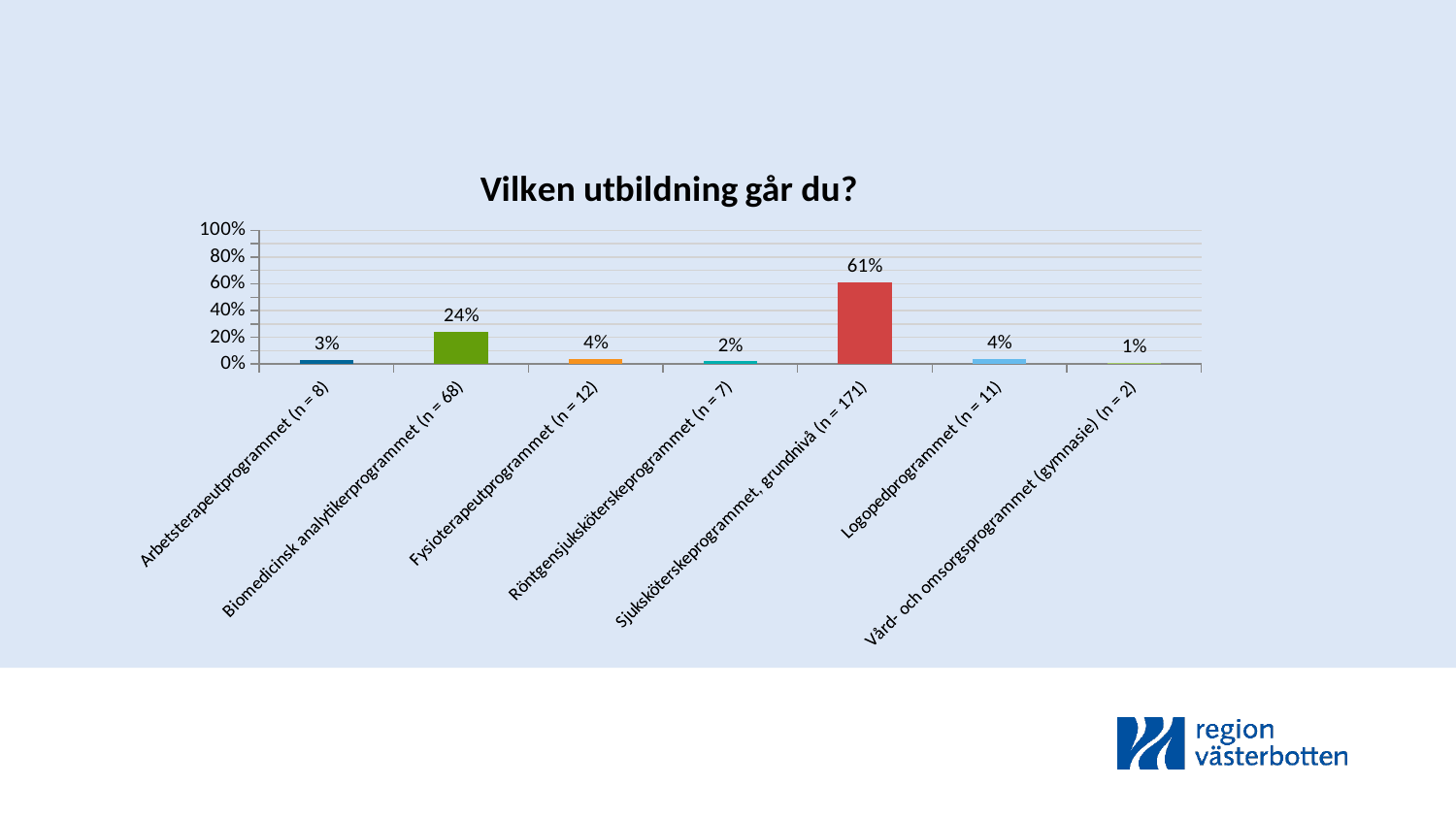
What is the value for Sjuksköterskeprogrammet, grundnivå (n = 171)? 61% What kind of chart is shown on the slide? bar chart How many categories are shown on the x axis? 7 Which category has the highest value? Sjuksköterskeprogrammet, grundnivå (n = 171) Which category has the lowest value? Vård- och omsorgsprogrammet (gymnasie) (n = 2) What is the value for Biomedicinsk analytikerprogrammet (n = 68)? 24% Is the value for Sjuksköterskeprogrammet, grundnivå greater or less than 40%? greater What is the value for Röntgensjuksköterskeprogrammet (n = 7)? 2% Which is larger, the value for Fysioterapeutprogrammet (n = 12) or the value for Röntgensjuksköterskeprogrammet (n = 7)? Fysioterapeutprogrammet (n = 12) What is the difference between the values for Sjuksköterskeprogrammet, grundnivå and Biomedicinsk analytikerprogrammet? 37% What is the title of the chart? Vilken utbildning går du? What is the value for Arbetsterapeutprogrammet (n = 8)? 3%